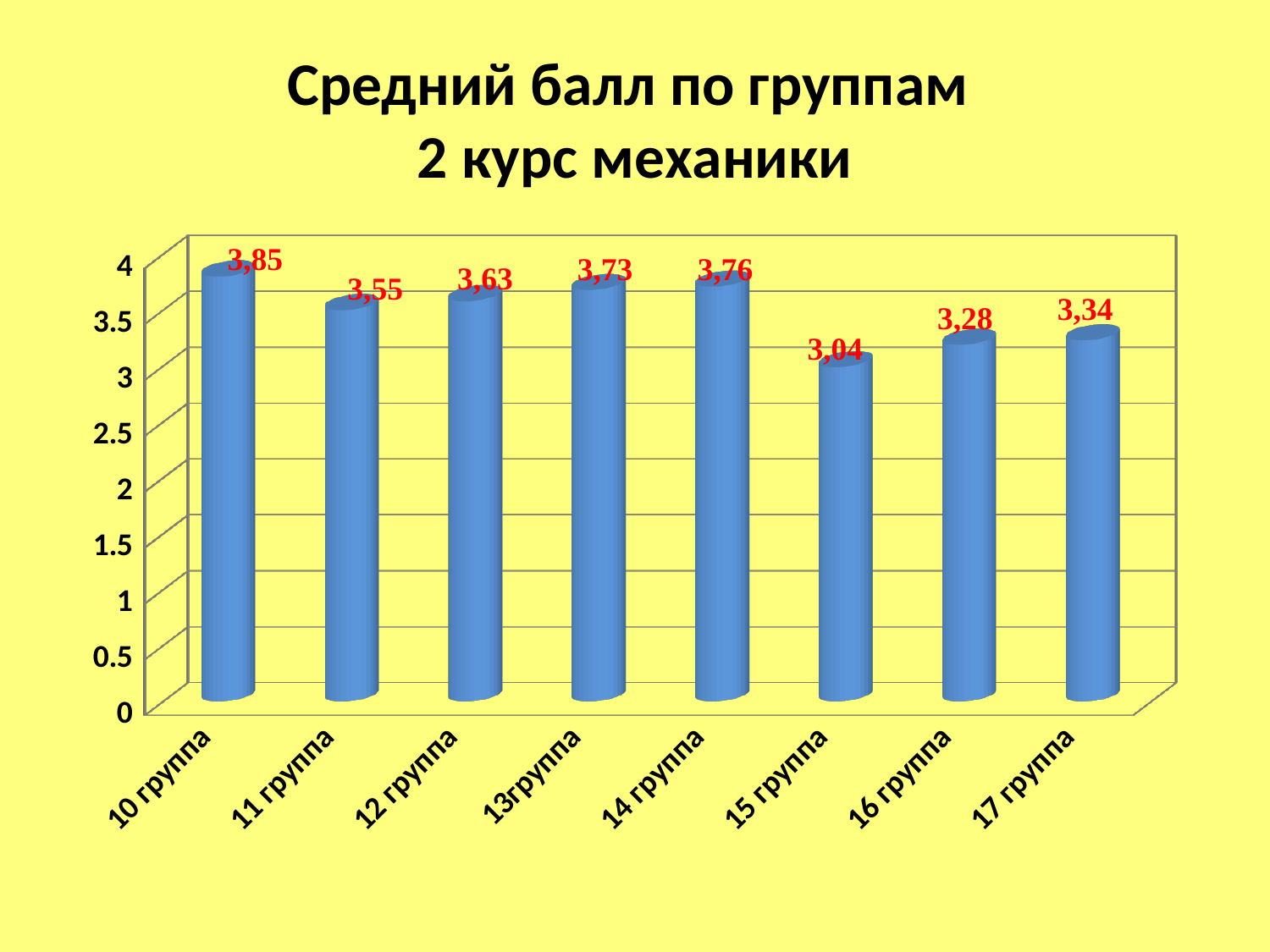
What is the difference between the values for 10 группа and 15 группа? 0,81 What kind of chart is shown on the slide? bar chart What is the value for 15 группа? 3,04 What is the value for 17 группа? 3,34 What is the value for 10 группа? 3,85 What is the title of the chart? Средний балл по группам 2 курс механики Is the value for 12 группа greater or less than 3.5? greater What is the difference between the values for 14 группа and 13группа? 0,03 Which group has the lowest average score? 15 группа How many groups are shown on the chart? 8 Which group has the highest average score? 10 группа Which is larger, the value for 11 группа or the value for 16 группа? 11 группа